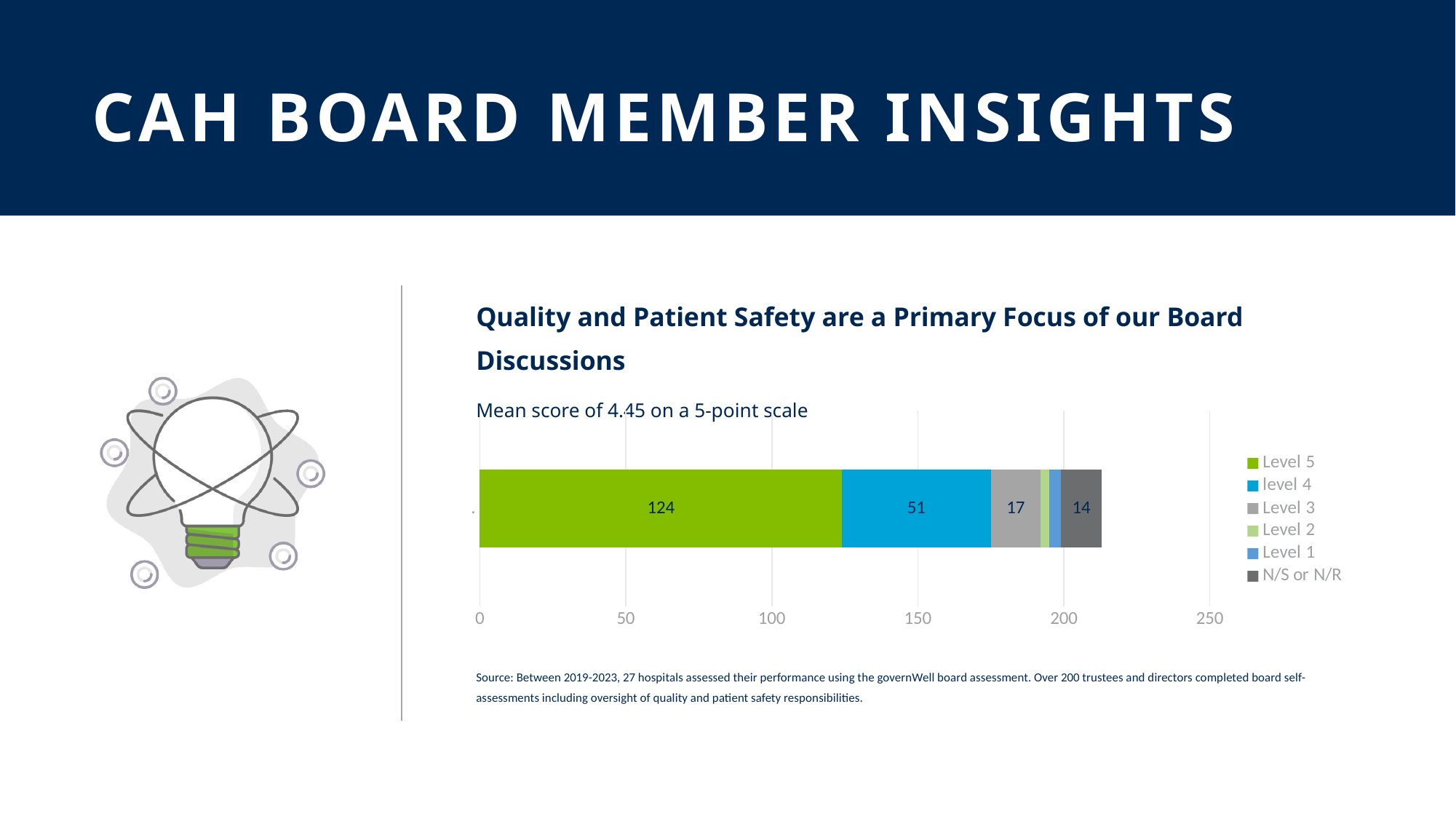
What is the value for level 4 in the stacked bar? 51 What is the difference between the Level 5 value and the level 4 value? 73 What is the value for Level 3 in the stacked bar? 17 How many series does the legend list? 6 Which is larger, the Level 3 value or the N/S or N/R value? Level 3 Is the total length of the stacked bar greater or less than 200? greater What kind of chart is shown on the slide? Stacked bar chart What is the title of the chart? Quality and Patient Safety are a Primary Focus of our Board Discussions What is the value for N/S or N/R in the stacked bar? 14 Which segment of the stacked bar has the highest value? Level 5 What is the value for Level 5 in the stacked bar? 124 What is the difference between the level 4 value and the Level 3 value? 34